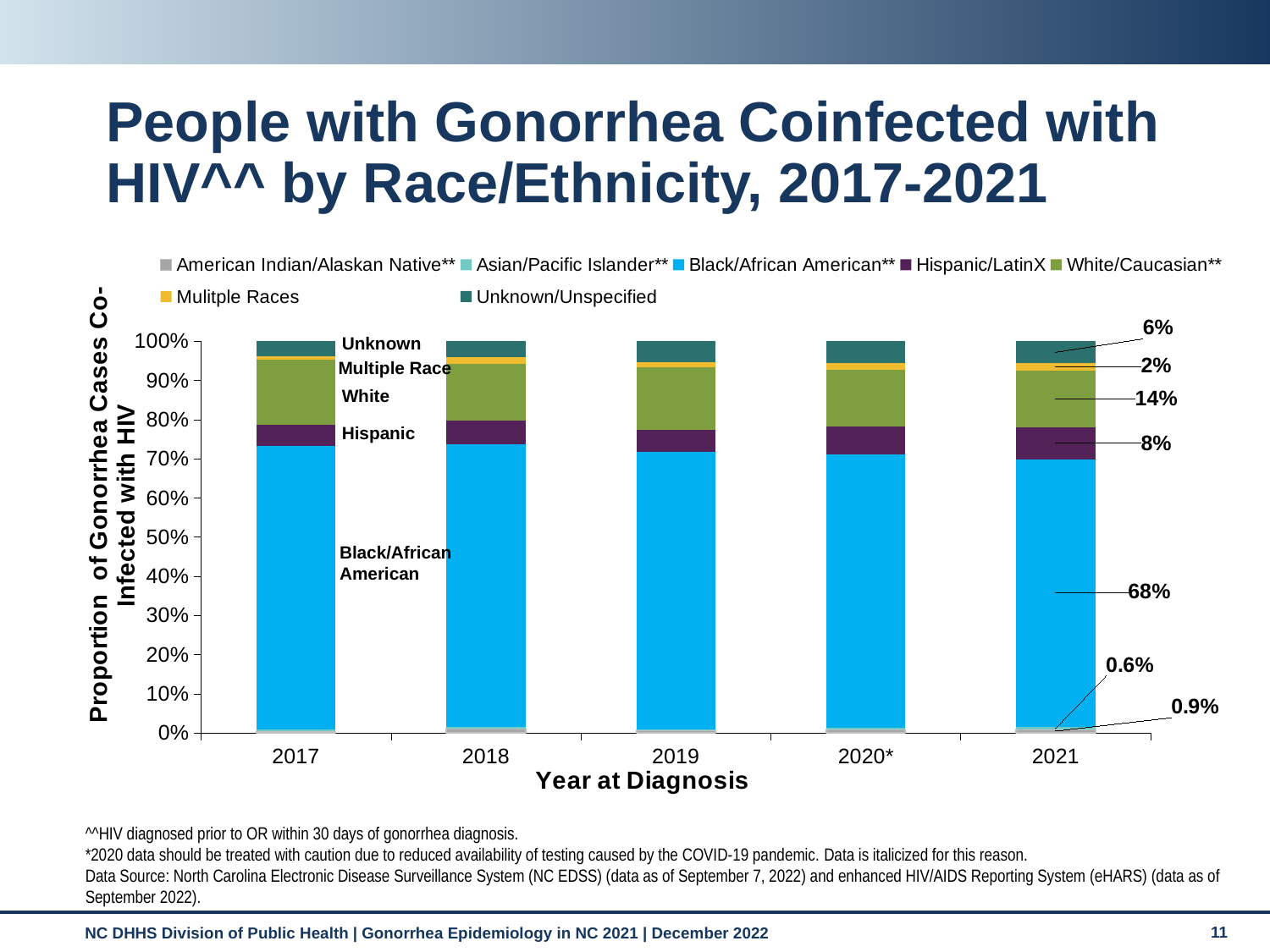
How many race/ethnicity series does the legend list? 7 Is the Black/African American share in 2017 greater or less than 70%? greater What is the title of the x axis? Year at Diagnosis What proportion of gonorrhea cases co-infected with HIV in 2021 were Hispanic/LatinX? 8% Which race/ethnicity group makes up the largest share of the 2021 bar? Black/African American What proportion of gonorrhea cases co-infected with HIV in 2021 were of Multiple Races? 2% What kind of chart is shown on the slide? Stacked bar chart What proportion of gonorrhea cases co-infected with HIV in 2021 were Unknown/Unspecified? 6% In 2021, how many percentage points larger is the White/Caucasian share than the Hispanic/LatinX share? 6 percentage points What proportion of gonorrhea cases co-infected with HIV in 2021 were Black/African American? 68% How many years are shown on the x axis? 5 What proportion of gonorrhea cases co-infected with HIV in 2021 were White/Caucasian? 14%